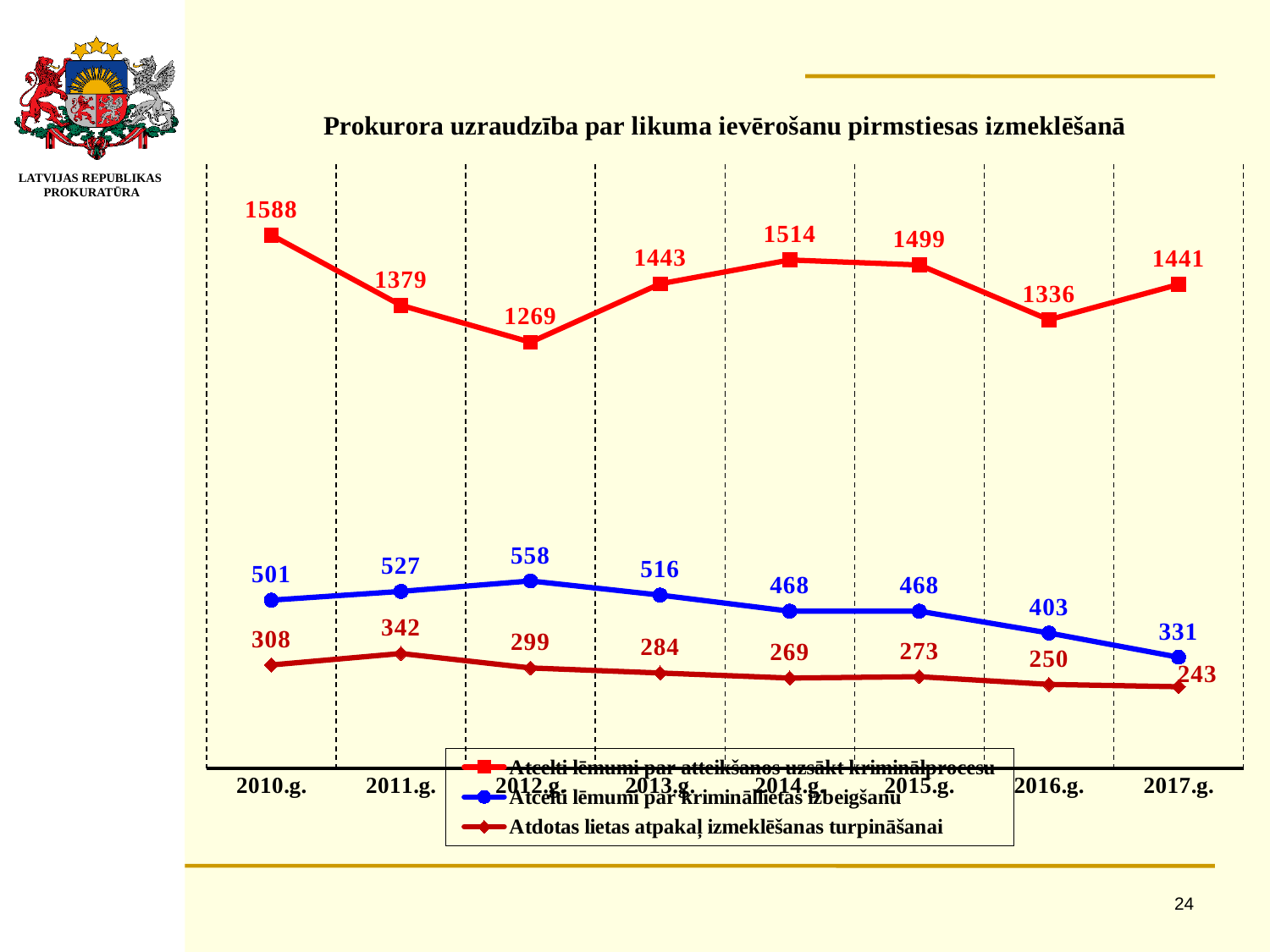
Does the blue circle-marker series rise or fall from 2013.g. to 2017.g.? fall What is the value of the red square-marker series (top line) for 2010.g.? 1588 How many years are plotted along the x axis? 8 What is the difference between the red square-marker series values for 2010.g. and 2011.g.? 209 What is the title of the chart? Prokurora uzraudzība par likuma ievērošanu pirmstiesas izmeklēšanā How many series does the legend list? 3 In which year does the red square-marker series (top line) reach its lowest value? 2012.g. What is the value of the blue circle-marker series for 2012.g.? 558 What is the value of the dark red diamond-marker series (bottom line) for 2017.g.? 243 Which is larger for the blue circle-marker series: the value for 2013.g. or the value for 2016.g.? 2013.g. In which year does the blue circle-marker series reach its highest value? 2012.g. What type of chart is shown on the slide? line chart